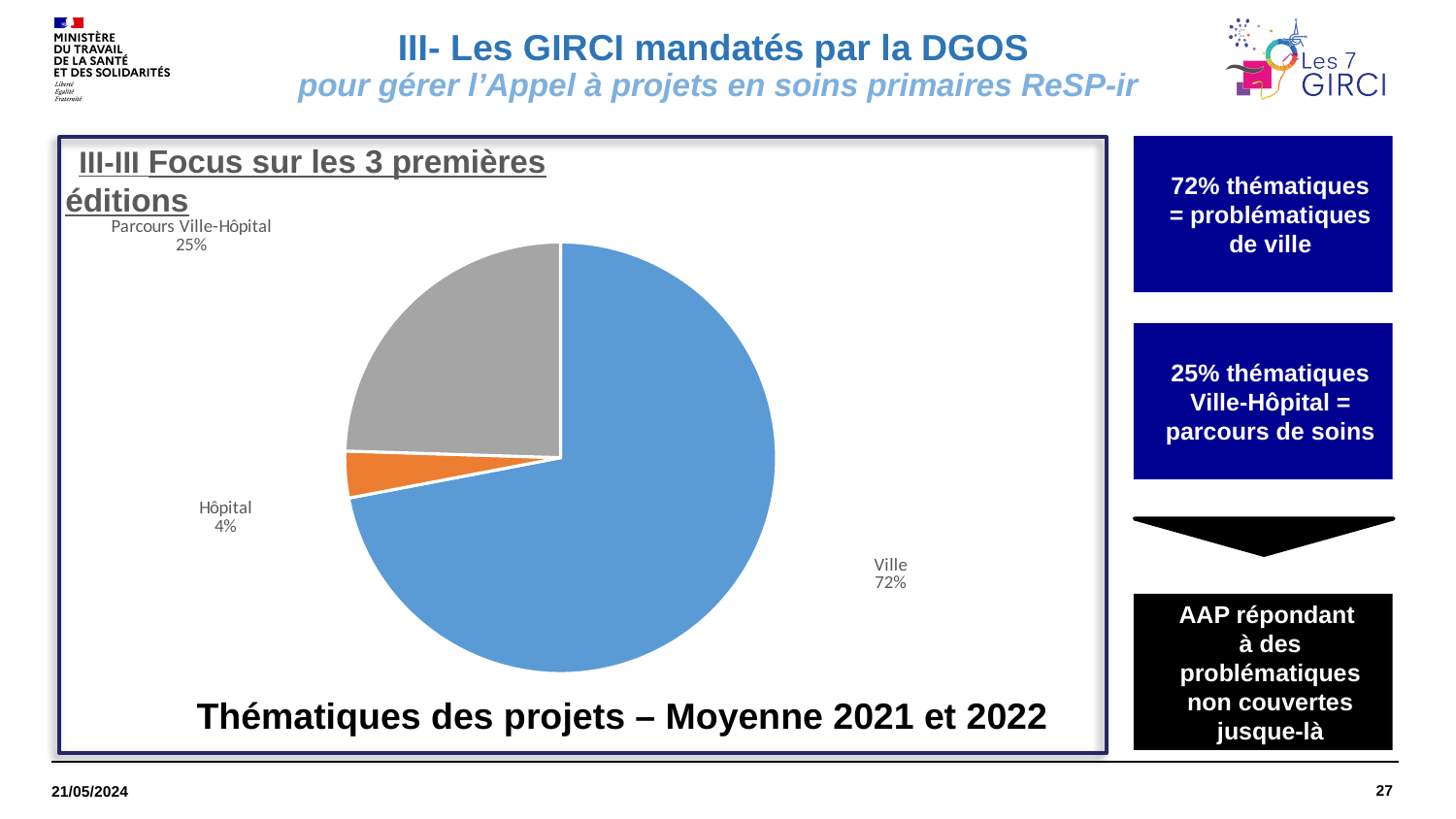
Which category has the largest slice of the pie chart? Ville How many slices does the pie chart have? 3 What colour is the Ville slice of the pie chart? blue What percentage of the pie chart is labelled Hôpital? 4% What is the difference in percentage points between the Ville slice and the Parcours Ville-Hôpital slice? 47 What is the difference in percentage points between the Parcours Ville-Hôpital slice and the Hôpital slice? 21 Which category has the smallest slice of the pie chart? Hôpital Which slice is larger, Parcours Ville-Hôpital or Hôpital? Parcours Ville-Hôpital What percentage of the pie chart is labelled Ville? 72% What type of chart is shown on the slide? pie chart What is the title of the pie chart? Thématiques des projets – Moyenne 2021 et 2022 What percentage of the pie chart is labelled Parcours Ville-Hôpital? 25%